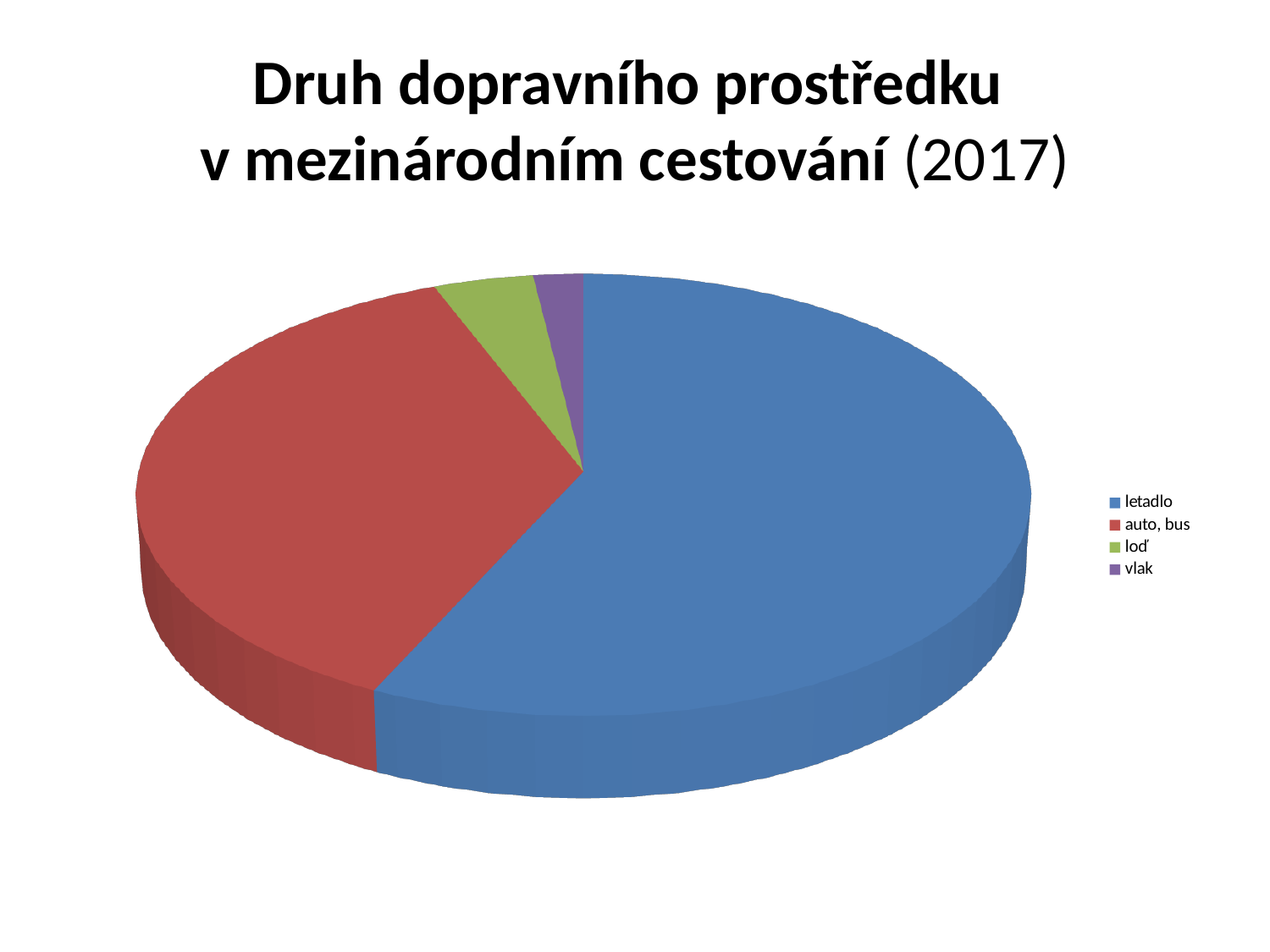
Which category has the largest slice of the pie? letadlo What kind of chart is shown on the slide? pie chart Which category has the second largest slice of the pie? auto, bus Which slice is larger, auto, bus or loď? auto, bus How many categories does the pie chart show? 4 What colour is the slice for letadlo? blue Which slice is larger, loď or vlak? loď What is the title of the chart? Druh dopravního prostředku v mezinárodním cestování (2017) How many entries does the legend list? 4 Which slice is larger, letadlo or auto, bus? letadlo Which category has the smallest slice of the pie? vlak